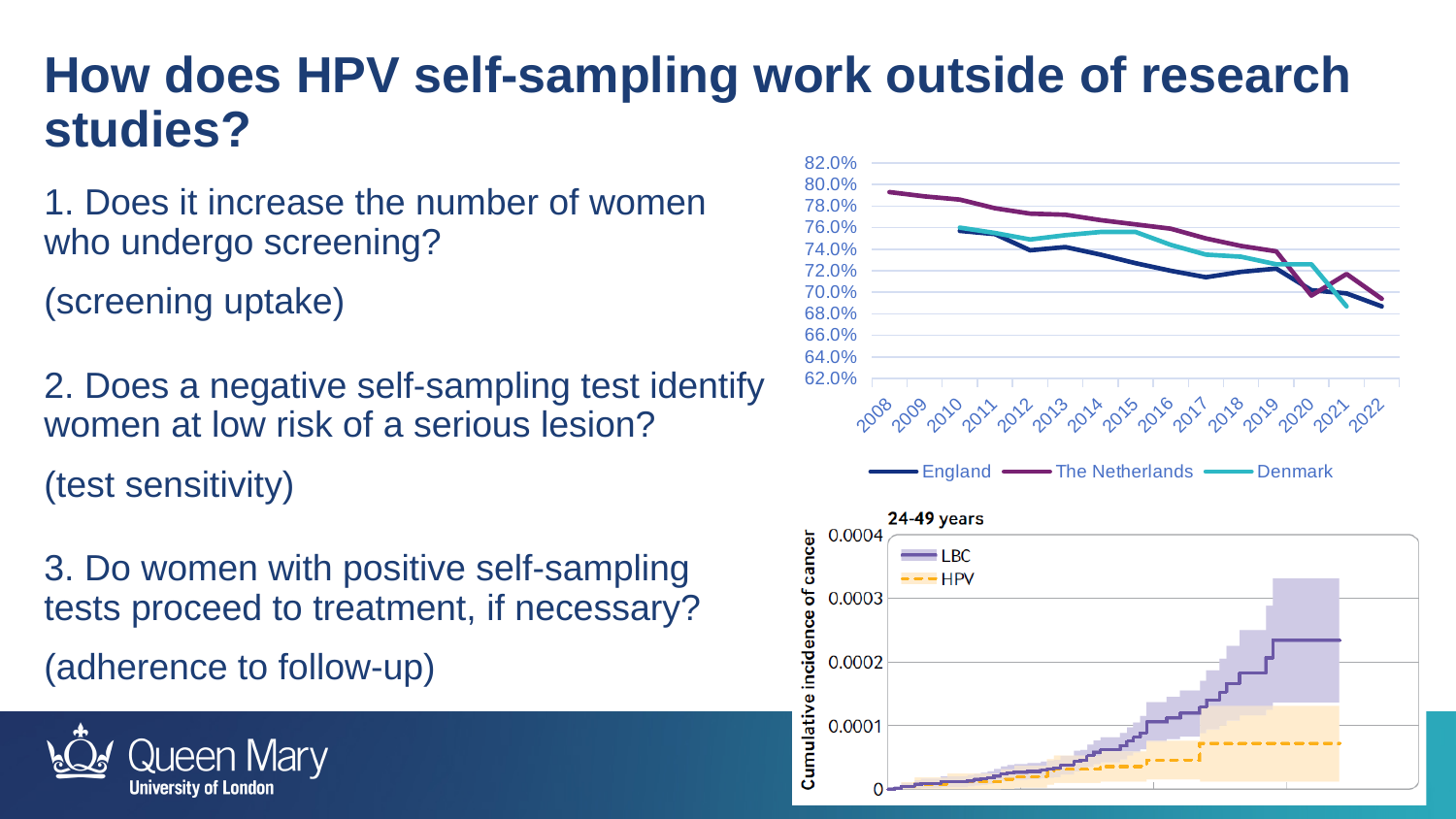
In the top-right line chart, do the screening values generally rise or fall from 2008 to 2022? fall What type of chart is the top-right chart showing England, The Netherlands and Denmark? line chart How many series does the legend of the top-right line chart list? 3 In the top-right line chart, is the value for England in 2017 greater or less than 74.0%? less How many years are shown on the x axis of the top-right line chart? 15 In the top-right line chart, is the value for England in 2022 greater or less than 70.0%? less How many series does the legend of the bottom-right chart (24-49 years) list? 2 What is the title of the bottom-right chart? 24-49 years In the top-right line chart, which country has the highest value in 2010? The Netherlands In the bottom-right chart (24-49 years), which series reaches the higher cumulative incidence of cancer at the right end? LBC In the top-right line chart, is the value for The Netherlands in 2008 greater or less than 78.0%? greater In the top-right line chart, which is higher in 2012: England or The Netherlands? The Netherlands